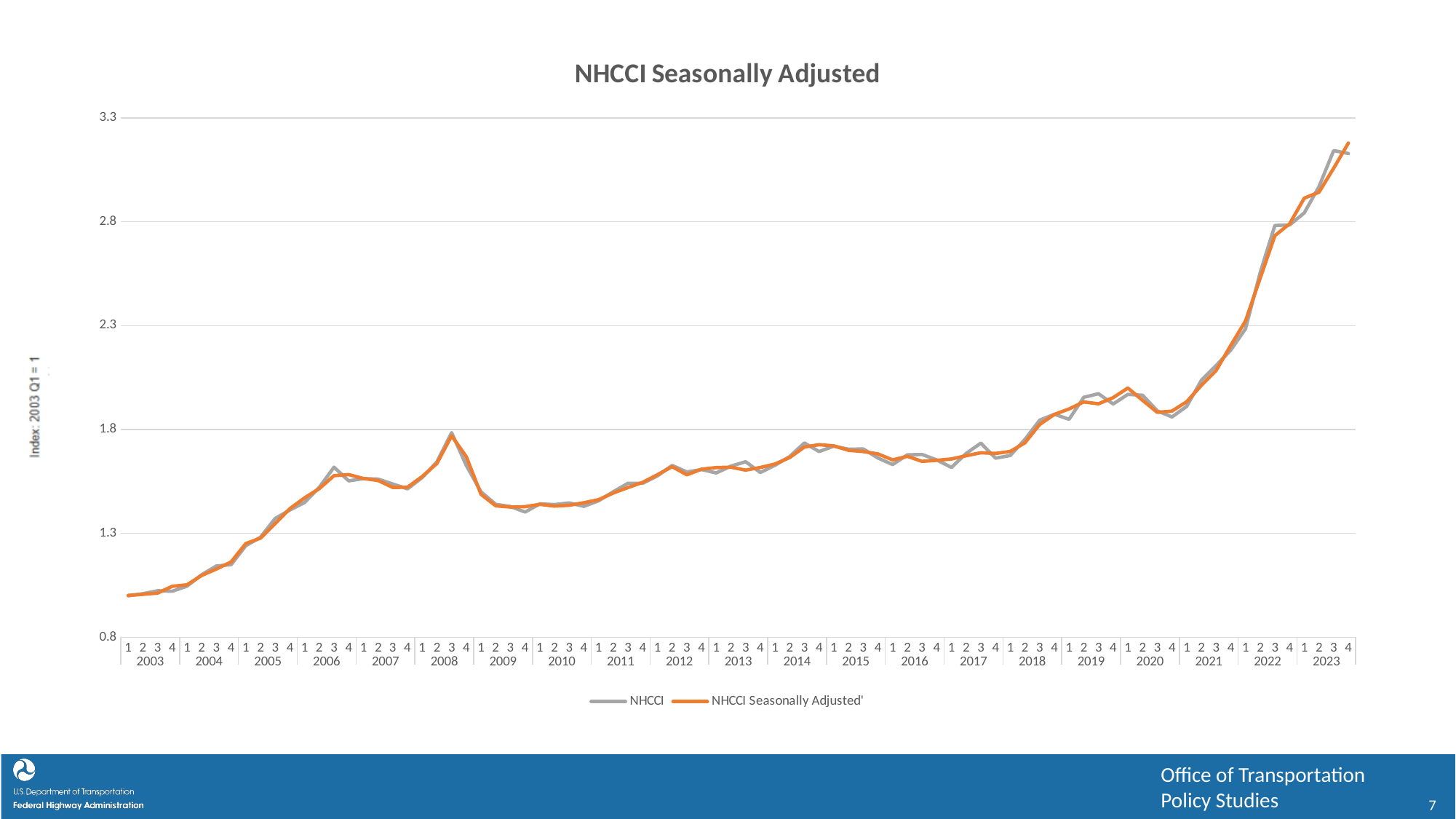
What is the title of the chart? NHCCI Seasonally Adjusted Is the NHCCI Seasonally Adjusted value for 2023 Q4 greater or less than 2.8? greater How many series does the legend list? 2 Is the NHCCI Seasonally Adjusted value for 2003 Q1 greater or less than 1.3? less In which year and quarter does the NHCCI Seasonally Adjusted series have its lowest value? 2003 Q1 Is the NHCCI Seasonally Adjusted value for 2016 Q1 greater or less than 1.8? less What type of chart is shown on the slide? line chart How many years are shown along the x axis? 21 Which is larger for the NHCCI series: the value in 2008 Q3 or the value in 2009 Q4? 2008 Q3 What are the two series named in the legend? NHCCI and NHCCI Seasonally Adjusted Overall, do the values rise or fall from 2003 to 2023? rise In which year and quarter does the NHCCI Seasonally Adjusted series reach its highest value? 2023 Q4